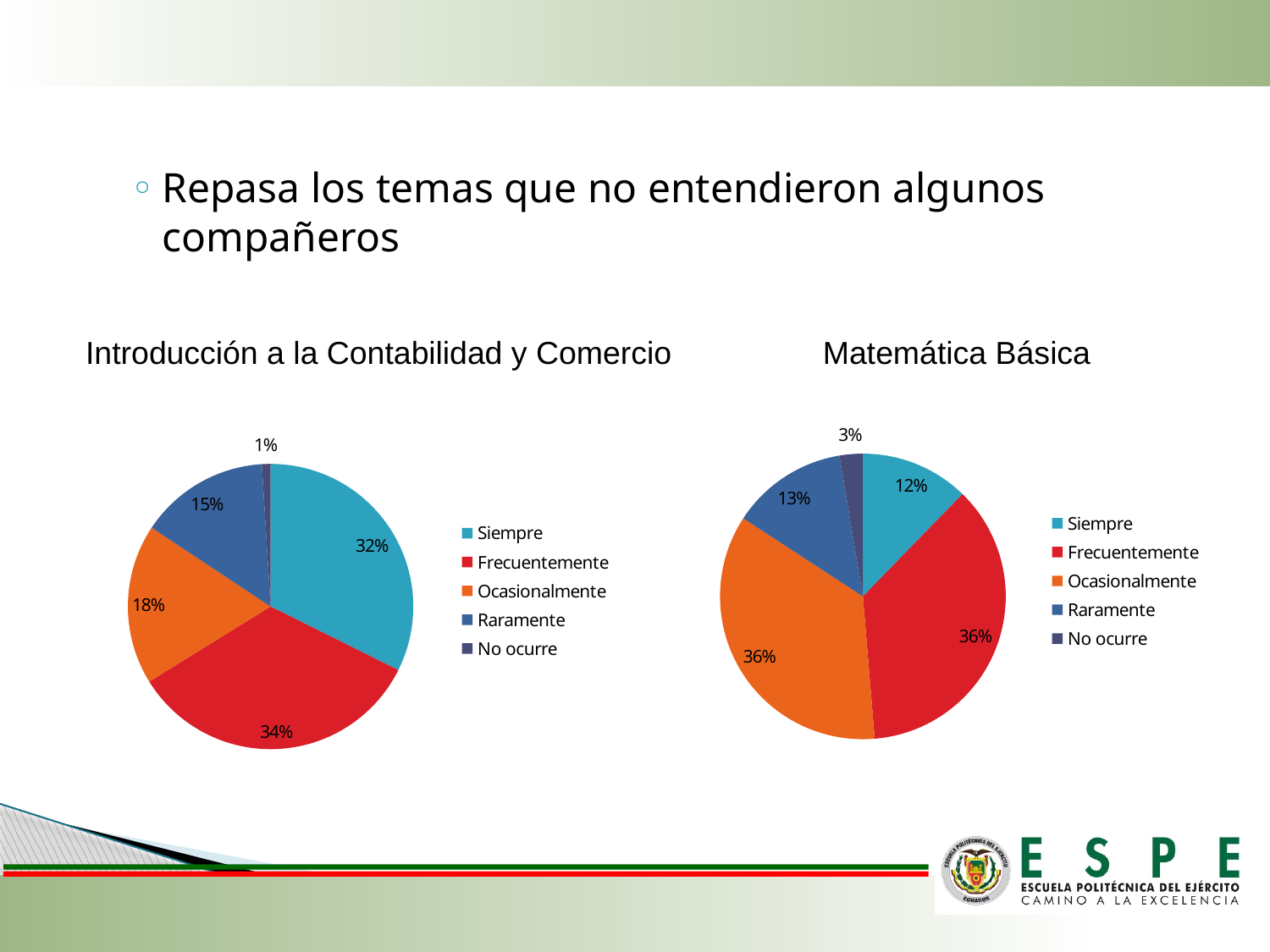
In the 'Introducción a la Contabilidad y Comercio' pie chart, which category has the largest slice? Frecuentemente What type of chart is used for 'Introducción a la Contabilidad y Comercio'? Pie chart In the 'Introducción a la Contabilidad y Comercio' pie chart, what is the difference between the Frecuentemente and Raramente shares? 19% In the 'Introducción a la Contabilidad y Comercio' pie chart, which category has the smallest slice? No ocurre In the 'Matemática Básica' pie chart, which category has the smallest slice? No ocurre In the 'Matemática Básica' pie chart, what share is labelled for Raramente? 13% In the 'Matemática Básica' pie chart, what share is labelled for Siempre? 12% In the 'Introducción a la Contabilidad y Comercio' pie chart, what share is labelled for Siempre? 32% In the 'Matemática Básica' pie chart, which is larger: the Frecuentemente slice or the Siempre slice? Frecuentemente In the 'Introducción a la Contabilidad y Comercio' pie chart, what share is labelled for Ocasionalmente? 18% In the 'Matemática Básica' pie chart, what is the difference between the Ocasionalmente and Raramente shares? 23% How many categories does the legend of the 'Matemática Básica' chart list? 5